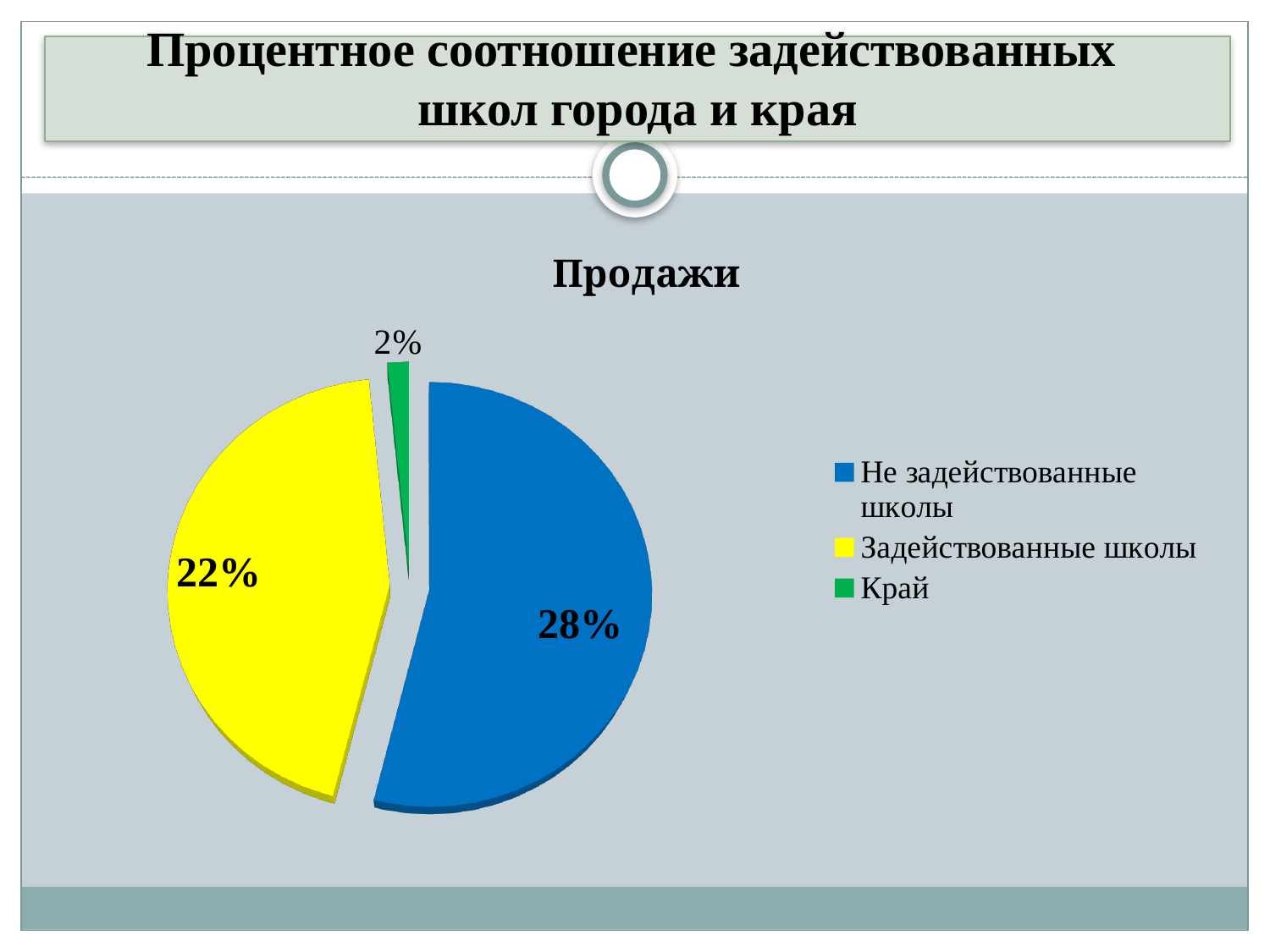
What is the difference between the labelled values for Не задействованные школы and Задействованные школы? 6% What value is labelled on the slice for Край? 2% What colour is the slice for Край? green What value is labelled on the slice for Задействованные школы? 22% Which is larger, the value for Задействованные школы or the value for Край? Задействованные школы How many slices does the pie chart have? 3 Which category has the largest slice of the pie? Не задействованные школы What kind of chart is shown on the slide? pie chart What is the chart's title? Продажи Which category has the smallest slice of the pie? Край How many entries does the legend list? 3 What value is labelled on the slice for Не задействованные школы? 28%